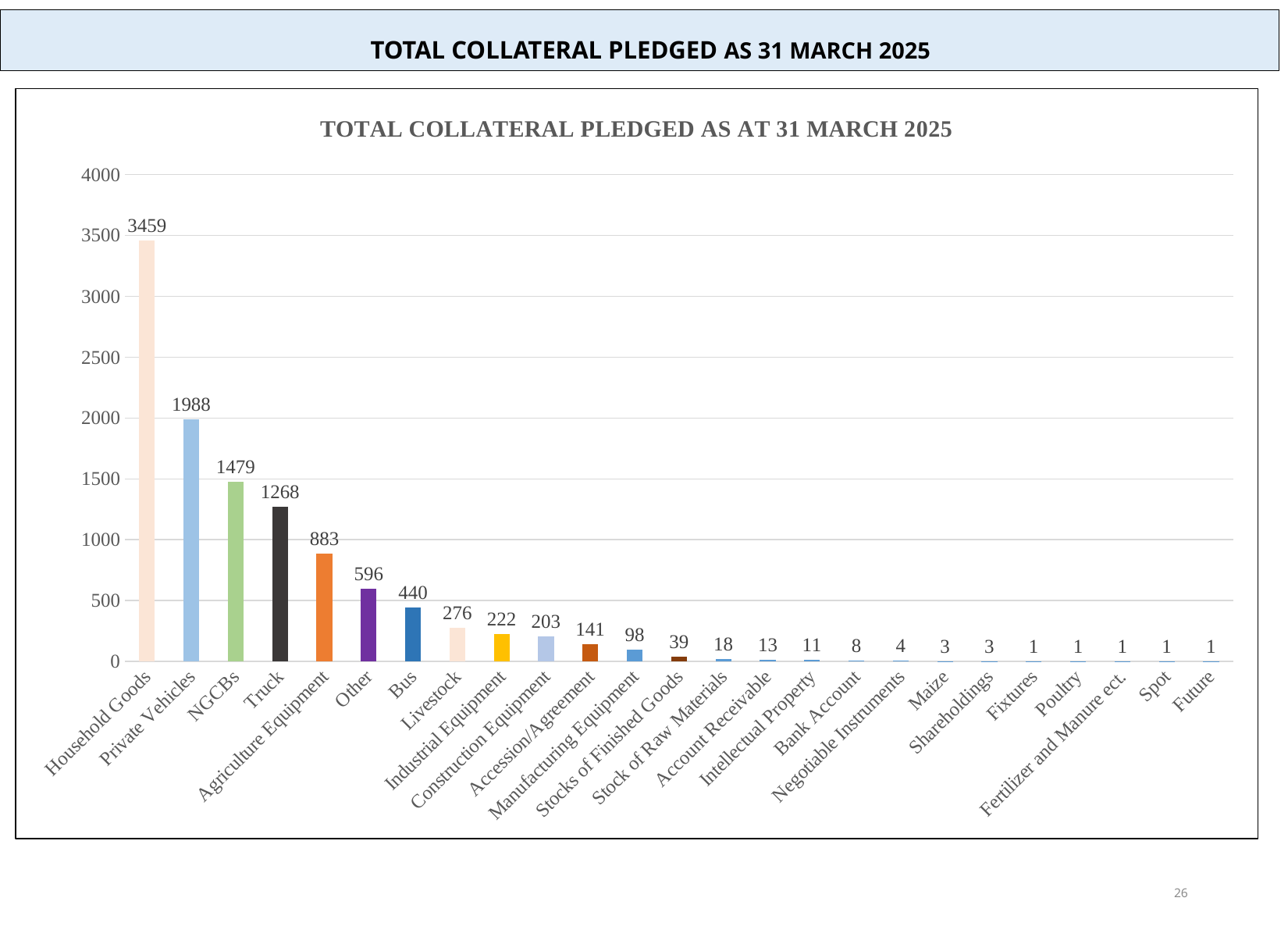
What is the value for Truck? 1268 Which category has the highest value? Household Goods What is the difference between Agriculture Equipment and Other? 287 What is the value for Stocks of Finished Goods? 39 What kind of chart is this? Bar chart What is the value for Livestock? 276 How many categories are shown on the x axis? 25 Which is larger, Industrial Equipment or Construction Equipment? Industrial Equipment What is the value for Household Goods? 3459 What is the difference between Private Vehicles and NGCBs? 509 Which is larger, Bus or Livestock? Bus Do the values rise or fall from left to right along the x axis? Fall